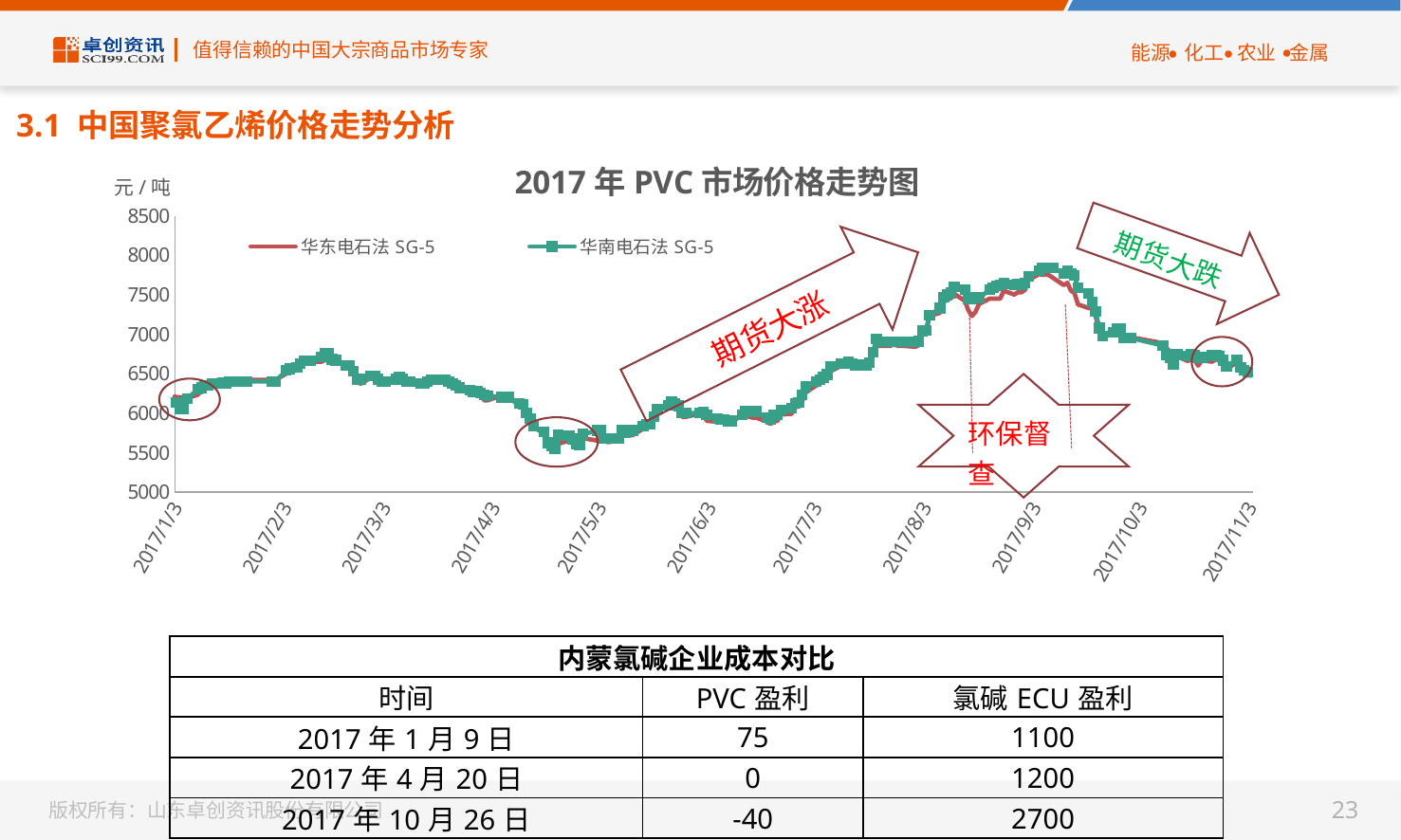
Is the value for 华南电石法 SG-5 around 2017/9/3 greater or less than 7500? greater How many series does the legend of the 2017年PVC市场价格走势图 list? 2 Around which x-axis date does the 华南电石法 SG-5 series reach its highest level? 2017/9/3 How many date ticks are shown on the x axis of the chart? 11 What are the two series named in the chart legend? 华东电石法 SG-5 and 华南电石法 SG-5 Is the value for 华南电石法 SG-5 around 2017/5/3 greater or less than 6000? less What is the title of the chart on the slide? 2017年PVC市场价格走势图 Between 2017/5/3 and 2017/9/3, do the PVC prices in the chart rise or fall? rise Is the value for 华南电石法 SG-5 at 2017/1/3 greater or less than 6500? less What kind of chart is the 2017年PVC市场价格走势图? line chart Around which x-axis date does the 华南电石法 SG-5 series reach its lowest level? 2017/5/3